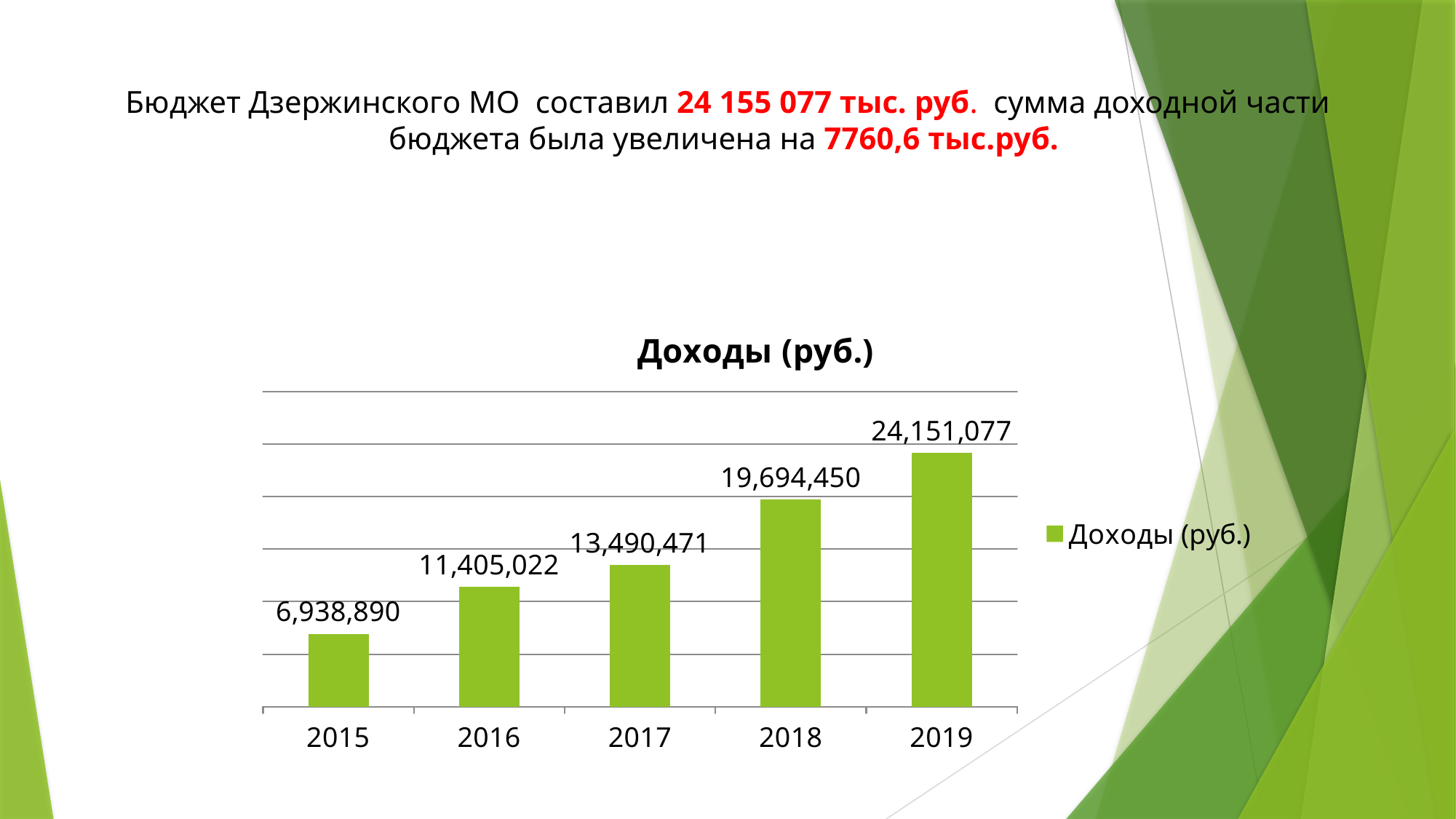
Do the values rise or fall from 2015 to 2019? rise What is the value for 2017 in the chart? 13,490,471 How many series does the legend list? 1 What is the difference between the values for 2016 and 2015? 4,466,132 What is the difference between the values for 2019 and 2018? 4,456,627 What is the value for 2015 in the chart? 6,938,890 What is the value for 2019 in the chart? 24,151,077 What kind of chart is shown on the slide? bar chart Which is larger, the value for 2017 or the value for 2018? 2018 Which year has the highest value in the chart? 2019 Which year has the lowest value in the chart? 2015 How many years are shown on the x axis of the chart? 5